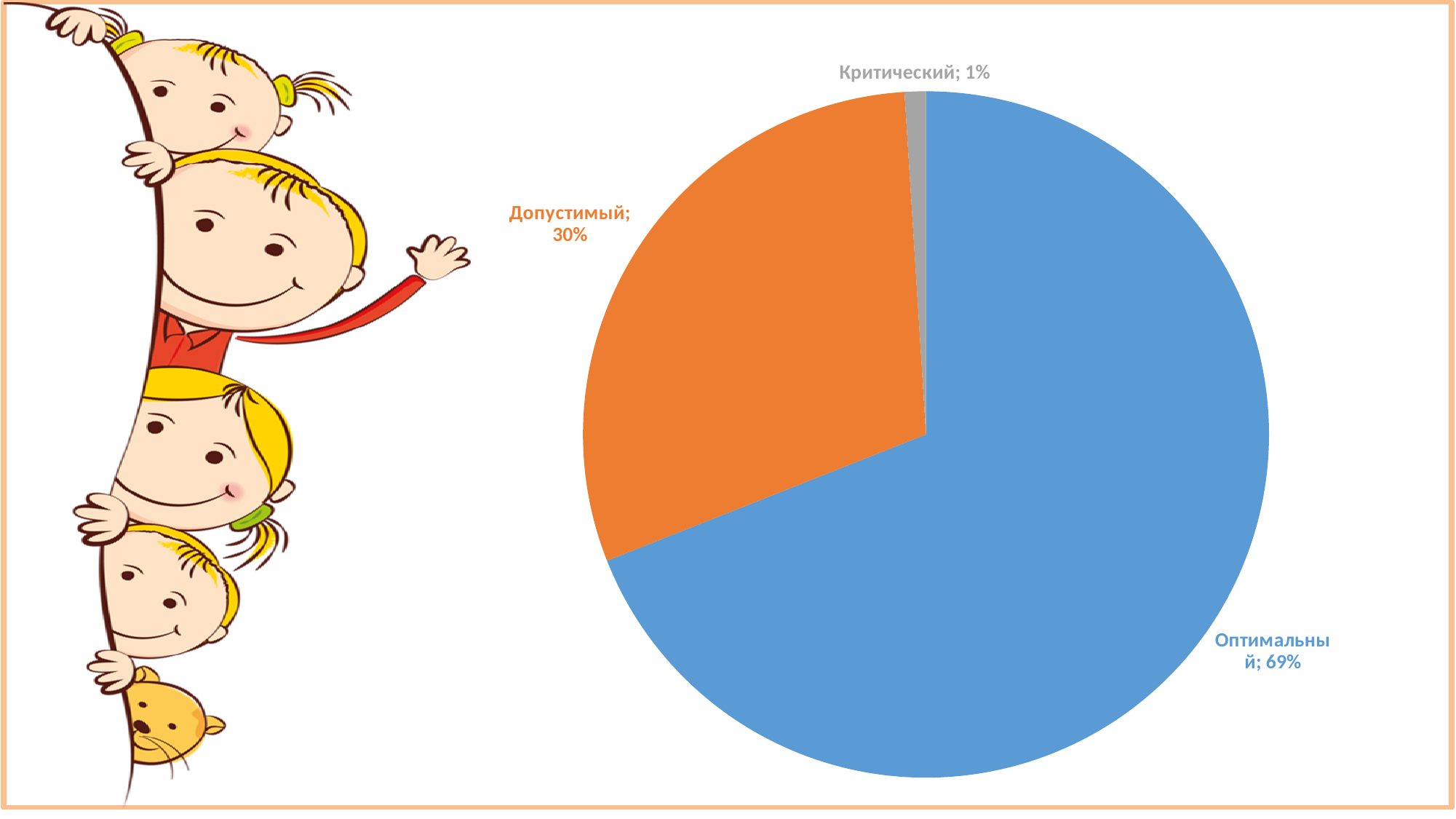
What share of the pie does the Допустимый slice have? 30% What share of the pie does the Критический slice have? 1% What colour is the Допустимый slice? orange What kind of chart is shown on the slide? pie chart Which slice of the pie is the largest? Оптимальный What share of the pie does the Оптимальный slice have? 69% What is the difference in percentage points between the Оптимальный and Допустимый slices? 39 What colour is the Оптимальный slice? blue What is the difference in percentage points between the Допустимый and Критический slices? 29 Which is larger, the Допустимый slice or the Критический slice? Допустимый How many slices does the pie chart have? 3 Which slice of the pie is the smallest? Критический